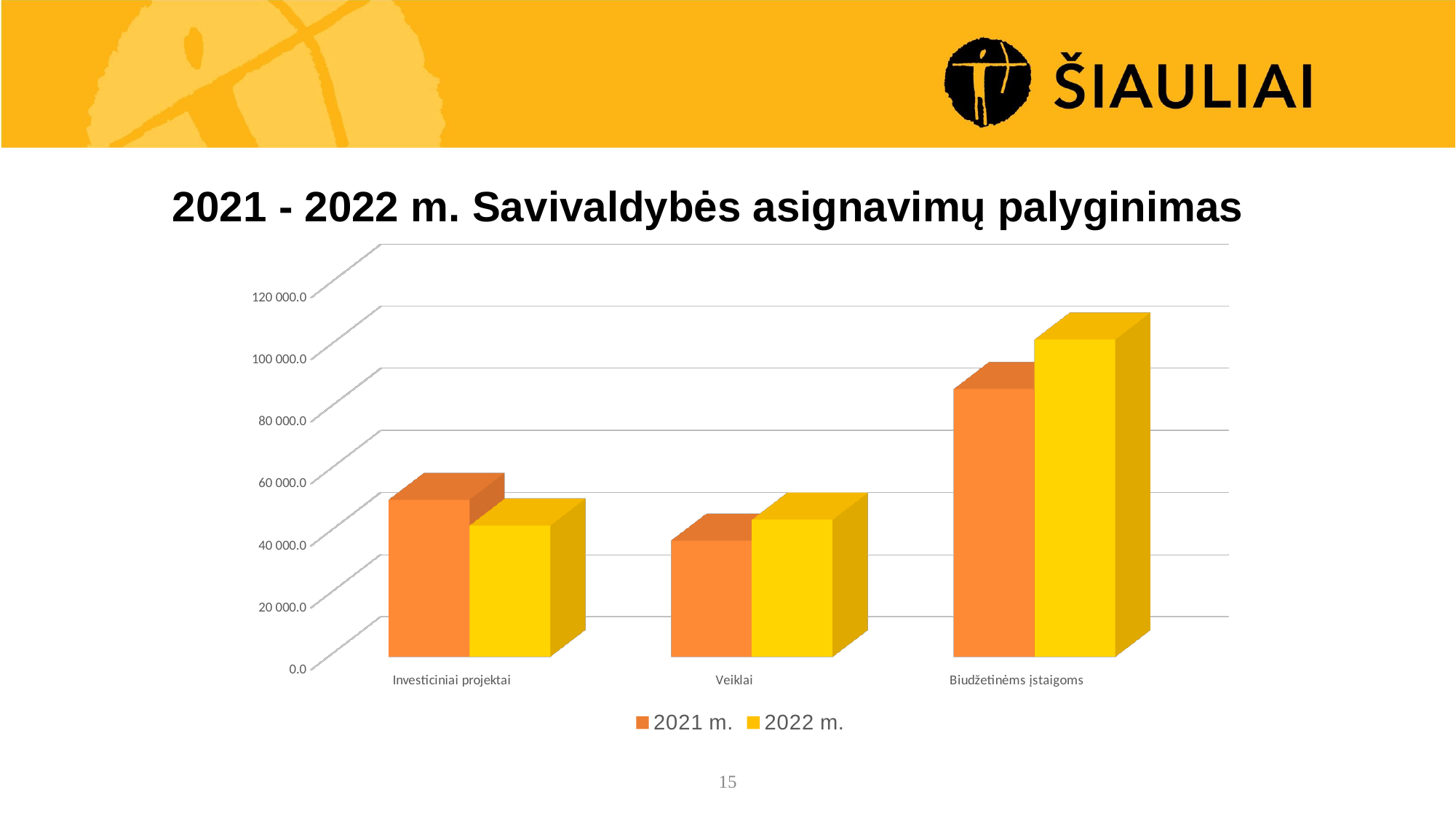
Which category has the lowest value for the 2021 m. series? Veiklai What is the title of the chart? 2021 - 2022 m. Savivaldybės asignavimų palyginimas Is the 2021 m. value for Veiklai greater or less than 60 000.0? less For Biudžetinėms įstaigoms, which series has the larger value, 2021 m. or 2022 m.? 2022 m. Is the 2022 m. value for Biudžetinėms įstaigoms greater or less than 80 000.0? greater How many series does the legend list? 2 Is the 2021 m. value for Investiciniai projektai greater or less than 40 000.0? greater What kind of chart is shown on the slide? bar chart How many categories are shown on the x axis? 3 Which category has the highest value for the 2022 m. series? Biudžetinėms įstaigoms For Investiciniai projektai, which series has the larger value, 2021 m. or 2022 m.? 2021 m. Which category has the highest value for the 2021 m. series? Biudžetinėms įstaigoms